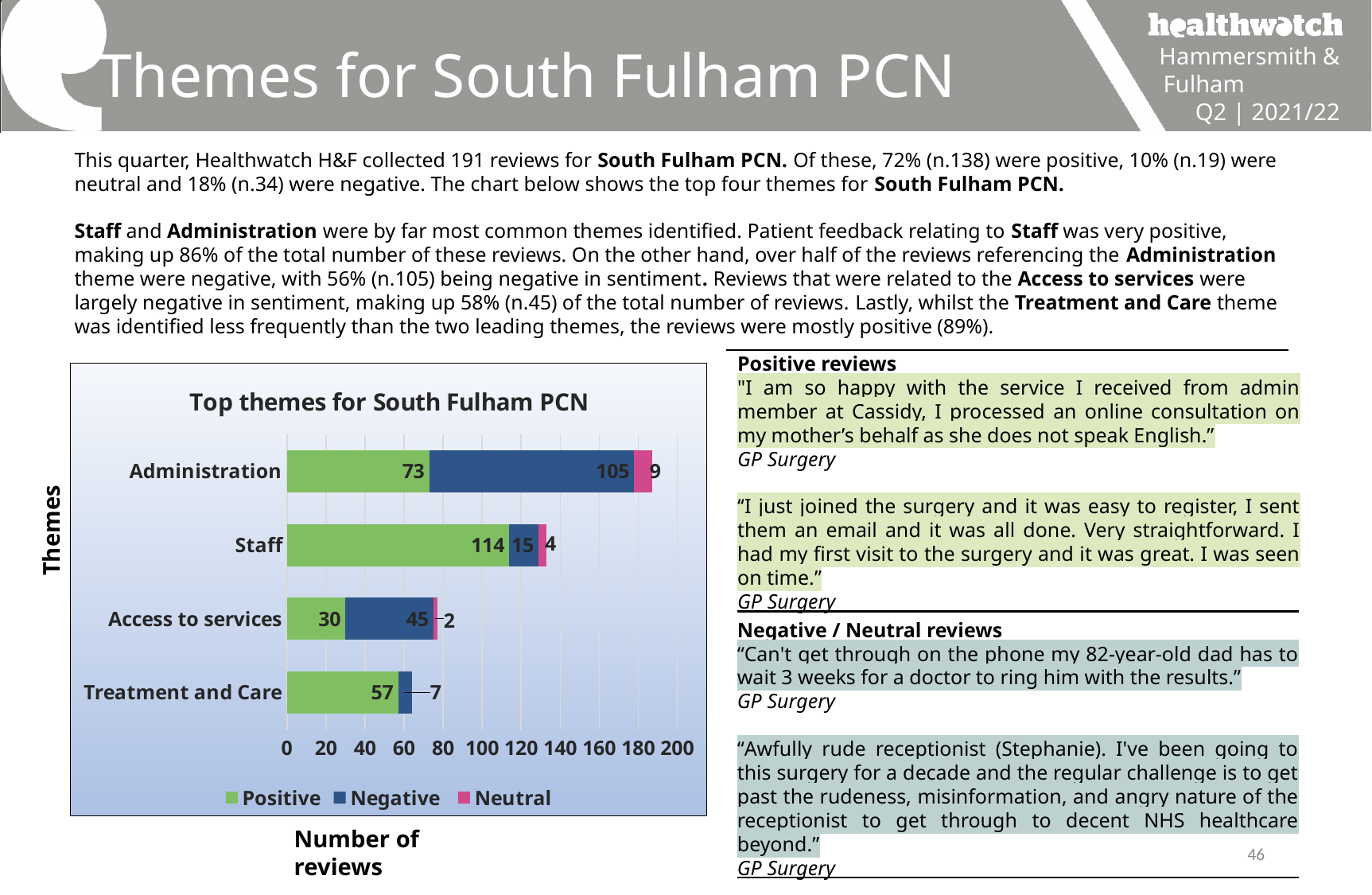
How many positive reviews are shown for Staff? 114 How many themes are plotted in the chart? 4 What kind of chart is shown on the slide? Bar chart What is the total number of reviews in the Administration bar? 187 How many negative reviews are shown for Access to services? 45 How many series does the chart legend list? 3 What is the title of the chart? Top themes for South Fulham PCN How many negative reviews are shown for Administration? 105 Which theme has the lowest number of positive reviews? Access to services What is the difference between the negative and positive review counts for Administration? 32 How many positive reviews are shown for Treatment and Care? 57 Which theme has the highest number of positive reviews? Staff